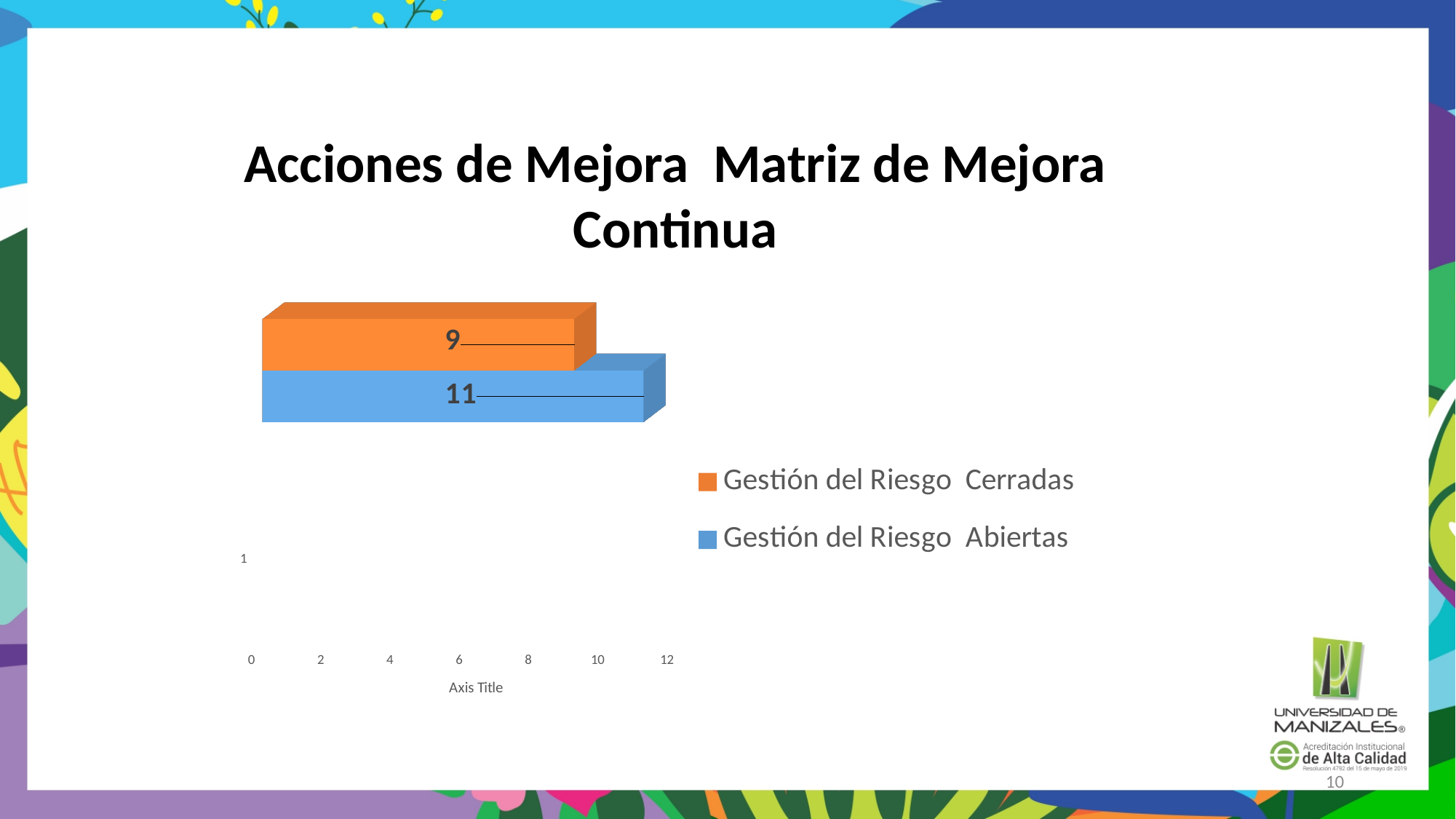
Which series has the higher value, Gestión del Riesgo Cerradas or Gestión del Riesgo Abiertas? Gestión del Riesgo Abiertas What kind of chart is shown on the slide? Bar chart What is the value for Gestión del Riesgo Cerradas? 9 What is the title of the chart? Acciones de Mejora Matriz de Mejora Continua Is the value for Gestión del Riesgo Cerradas greater or less than 10? less Which series has the highest value? Gestión del Riesgo Abiertas How many series does the legend list? 2 What colour is the bar for Gestión del Riesgo Cerradas? Orange Is the value for Gestión del Riesgo Abiertas greater or less than 10? greater What is the value for Gestión del Riesgo Abiertas? 11 What is the difference between the value for Gestión del Riesgo Abiertas and the value for Gestión del Riesgo Cerradas? 2 Which series has the lowest value? Gestión del Riesgo Cerradas